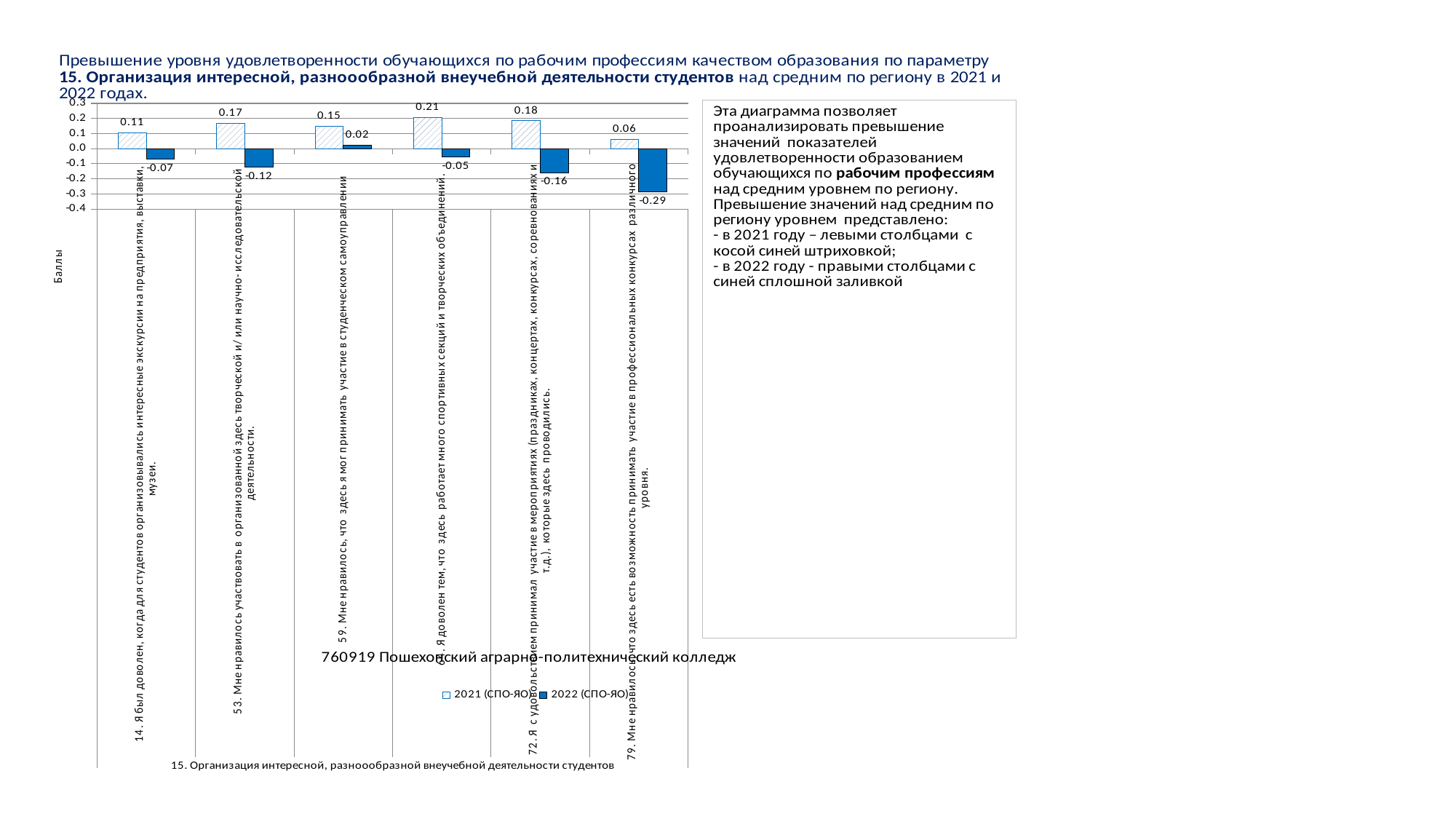
What is the difference between the 2021 and 2022 values for statement 72 (Я с удовольствием принимал участие в мероприятиях)? 0.34 What is the 2022 (СПО-ЯО) value for statement 79 (Мне нравилось, что здесь есть возможность принимать участие в профессиональных конкурсах различного уровня)? -0.29 Which statement has the highest 2021 (СПО-ЯО) value? Я доволен тем, что здесь работает много спортивных секций и творческих объединений (0.21) What kind of chart is shown on the slide? bar chart Which is larger for statement 14: the 2021 (СПО-ЯО) value or the 2022 (СПО-ЯО) value? 2021 (СПО-ЯО) What is the 2022 (СПО-ЯО) value for statement 53 (Мне нравилось участвовать в организованной здесь творческой и/или научно-исследовательской деятельности)? -0.12 How many series does the chart legend list? 2 Which statement has the lowest 2022 (СПО-ЯО) value? 79. Мне нравилось, что здесь есть возможность принимать участие в профессиональных конкурсах различного уровня (-0.29) What is the 2022 (СПО-ЯО) value for statement 59 (Мне нравилось, что здесь я мог принимать участие в студенческом самоуправлении)? 0.02 How many categories (statements) are plotted on the chart? 6 What is the label of the vertical axis of the chart? Баллы What is the 2021 (СПО-ЯО) value for statement 14 (Я был доволен, когда для студентов организовывались интересные экскурсии на предприятия, выставки, музеи)? 0.11